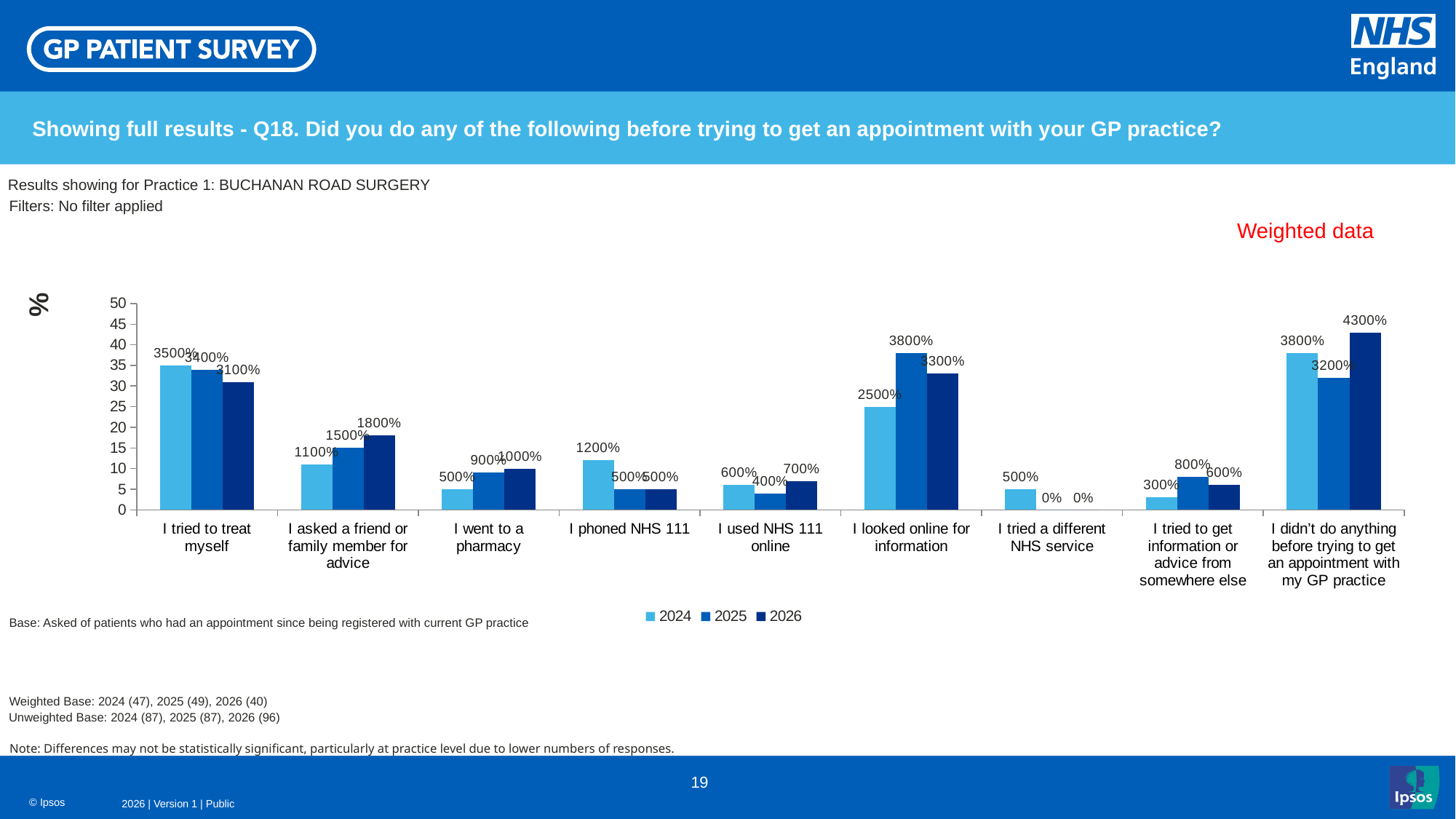
Which category has the highest 2026 value? I didn't do anything before trying to get an appointment with my GP practice Do the values for 'I tried to treat myself' rise or fall from 2024 to 2026? Fall What kind of chart is shown on the slide? Bar chart What is the difference between the 2026 and 2024 values for 'I didn't do anything before trying to get an appointment with my GP practice'? 500% Which category has the lowest 2025 value? I tried a different NHS service How many series does the legend list? 3 Which is larger for 'I went to a pharmacy': the 2024 value or the 2026 value? 2026 What is the 2026 value for 'I asked a friend or family member for advice'? 1800% What is the 2024 value for 'I tried to treat myself'? 3500% How many categories are shown on the x axis? 9 What is the 2025 value for 'I looked online for information'? 3800% What is the 2024 value for 'I phoned NHS 111'? 1200%